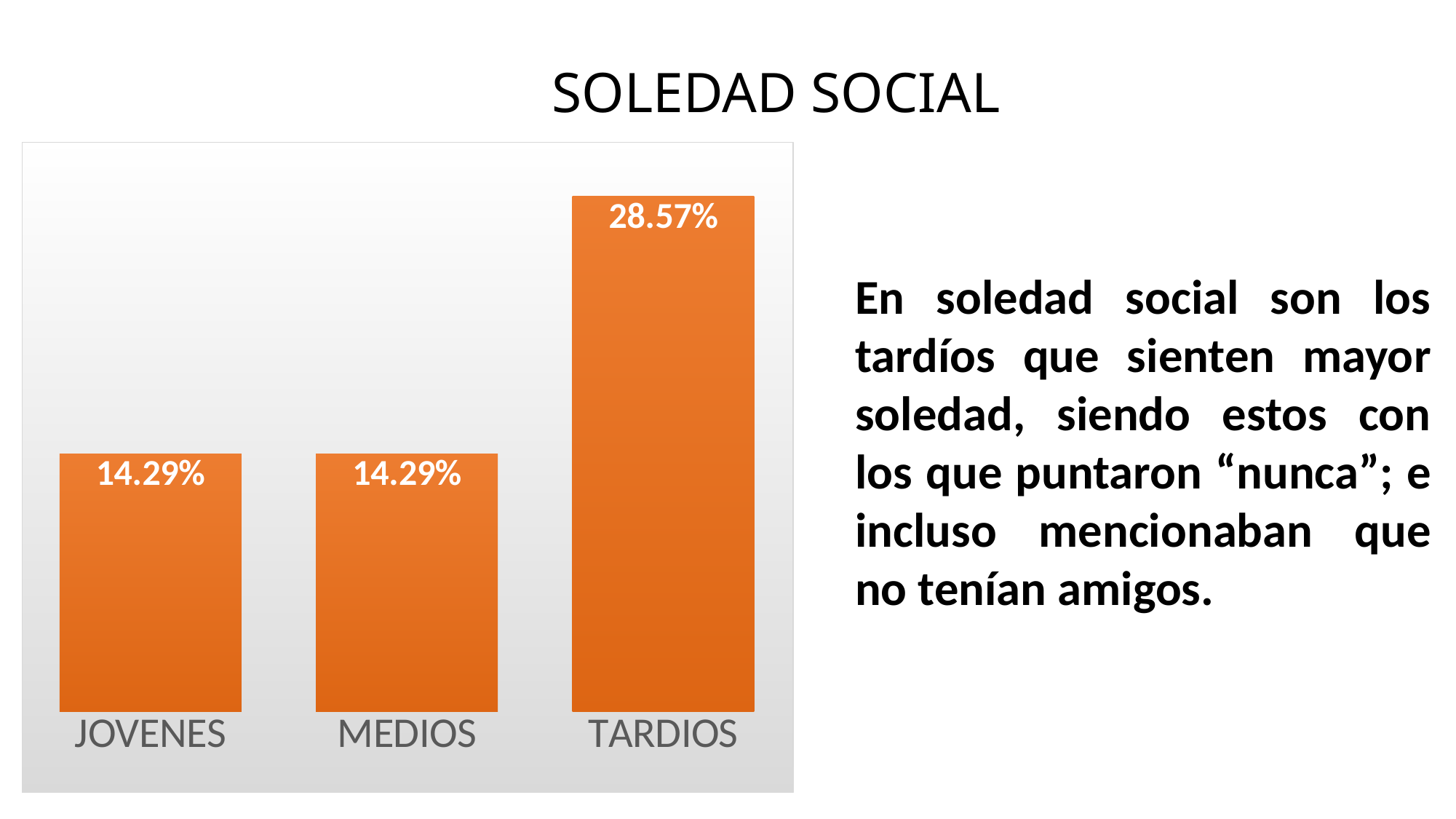
What kind of chart is shown on the slide? Bar chart What is the value for TARDIOS? 28.57% Do JOVENES and MEDIOS have the same value? Yes What colour are the bars in the chart? Orange What is the value for MEDIOS? 14.29% Which is larger, the value for TARDIOS or the value for MEDIOS? TARDIOS What is the value for JOVENES? 14.29% What is the title of the slide containing the chart? SOLEDAD SOCIAL Which category has the highest value? TARDIOS How many categories are shown in the chart? 3 Do the values rise or fall from JOVENES to TARDIOS along the x axis? Rise What is the difference between the values for TARDIOS and JOVENES? 14.28%